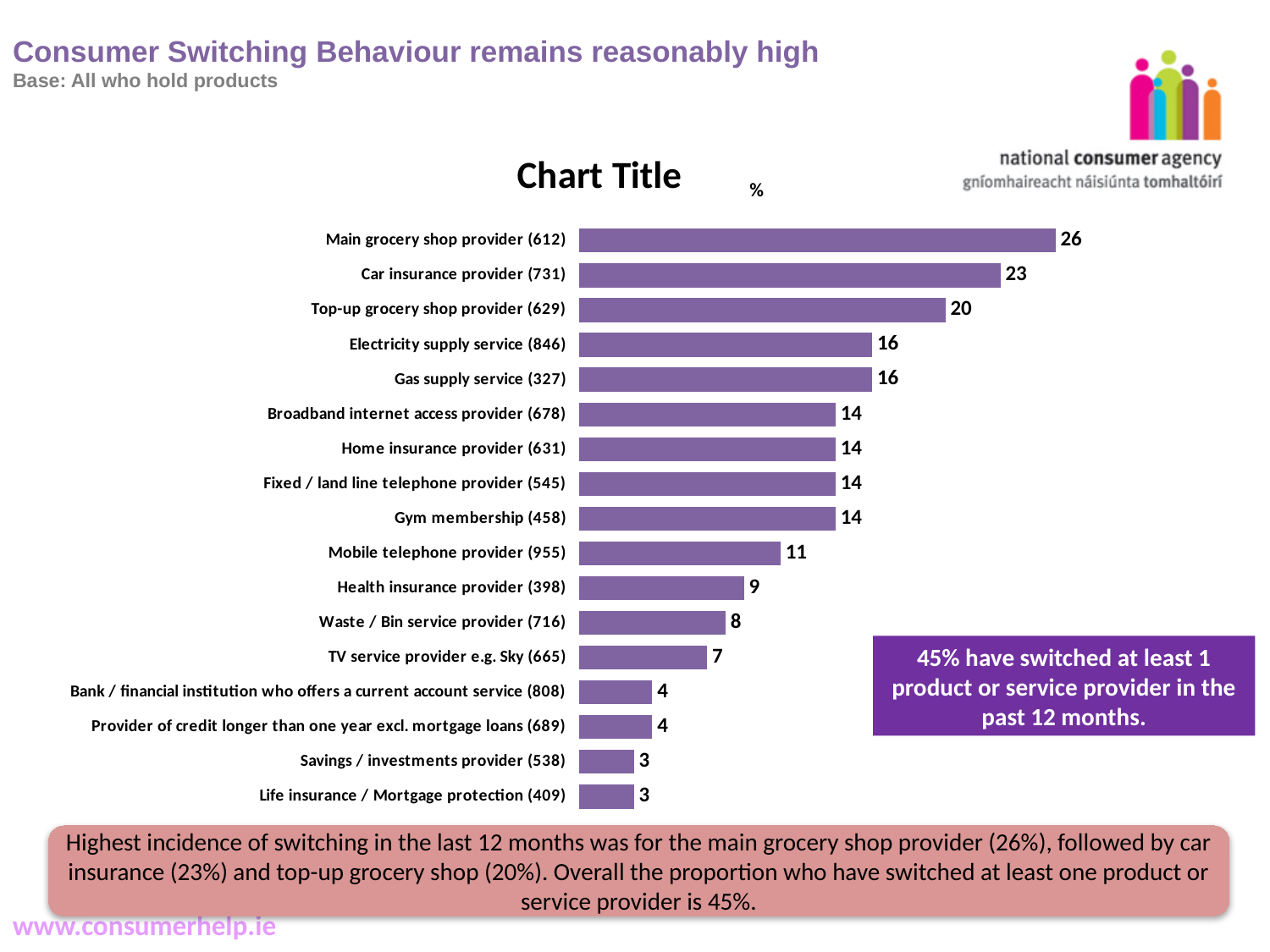
What is the value for Main grocery shop provider (612)? 26 What is the difference between Car insurance provider (731) and Top-up grocery shop provider (629)? 3 What is the value for Mobile telephone provider (955)? 11 What is the difference between Main grocery shop provider (612) and Life insurance / Mortgage protection (409)? 23 What colour are the bars in the chart? Purple What kind of chart is shown on the slide? Bar chart Which is larger, Electricity supply service (846) or Health insurance provider (398)? Electricity supply service (846) What is the value for Waste / Bin service provider (716)? 8 What is the title shown above the chart? Chart Title Which is larger, TV service provider e.g. Sky (665) or Gym membership (458)? Gym membership (458) How many categories are shown in the chart? 17 Which category has the highest value? Main grocery shop provider (612)